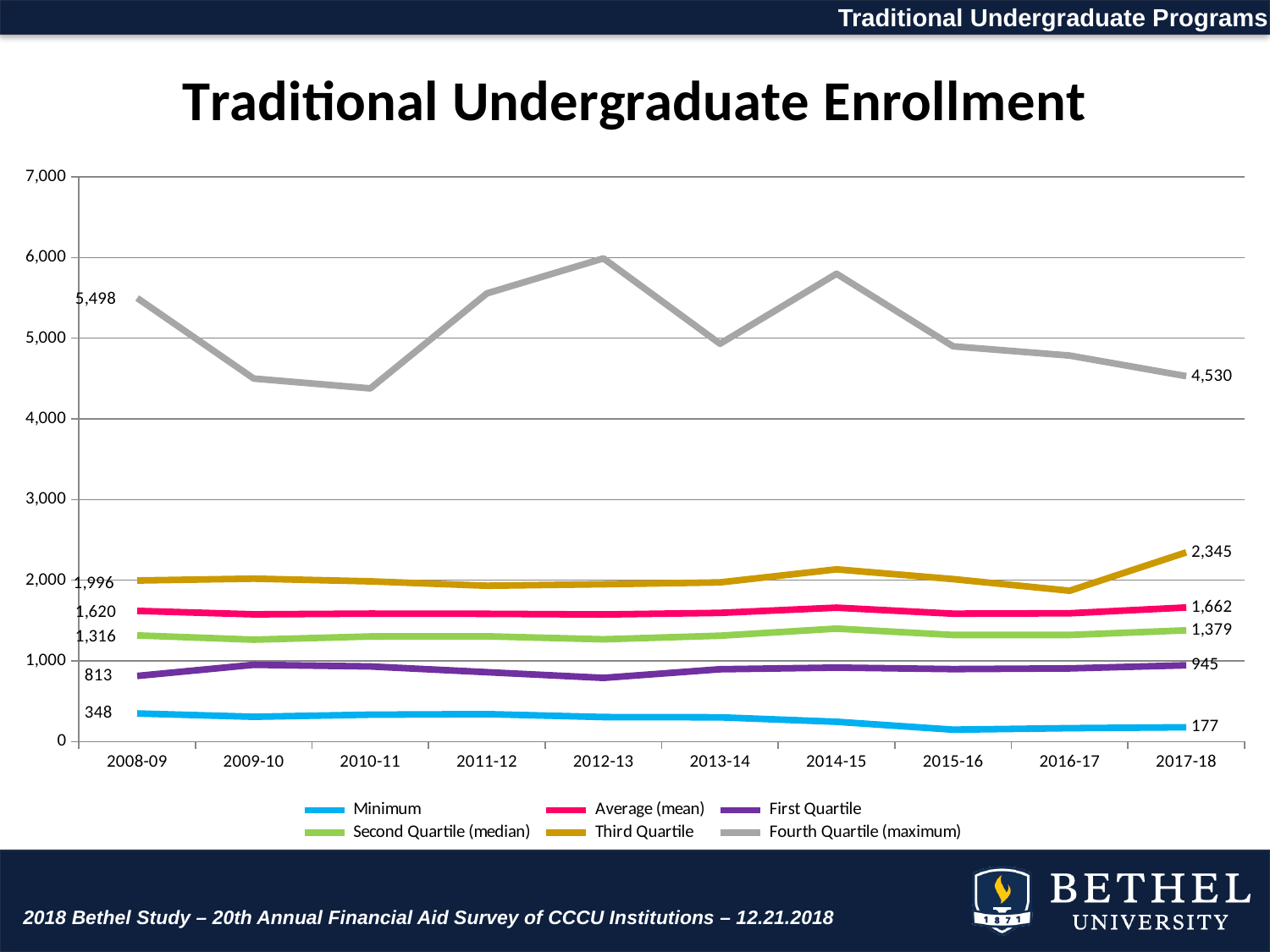
What is the Third Quartile value for 2017-18? 2,345 What is the Average (mean) value for 2008-09? 1,620 Which is larger, the First Quartile value for 2008-09 or for 2017-18? 2017-18 Is the Fourth Quartile (maximum) value for 2012-13 greater or less than 5,000? greater Does the Minimum series rise or fall from 2008-09 to 2017-18? fall How many series does the legend list? 6 What is the Minimum value for 2017-18? 177 What is the Fourth Quartile (maximum) value for 2008-09? 5,498 What is the title of the chart? Traditional Undergraduate Enrollment What is the difference between the Fourth Quartile (maximum) values for 2008-09 and 2017-18? 968 How many academic years are shown on the x axis? 10 What type of chart is shown on the slide? line chart